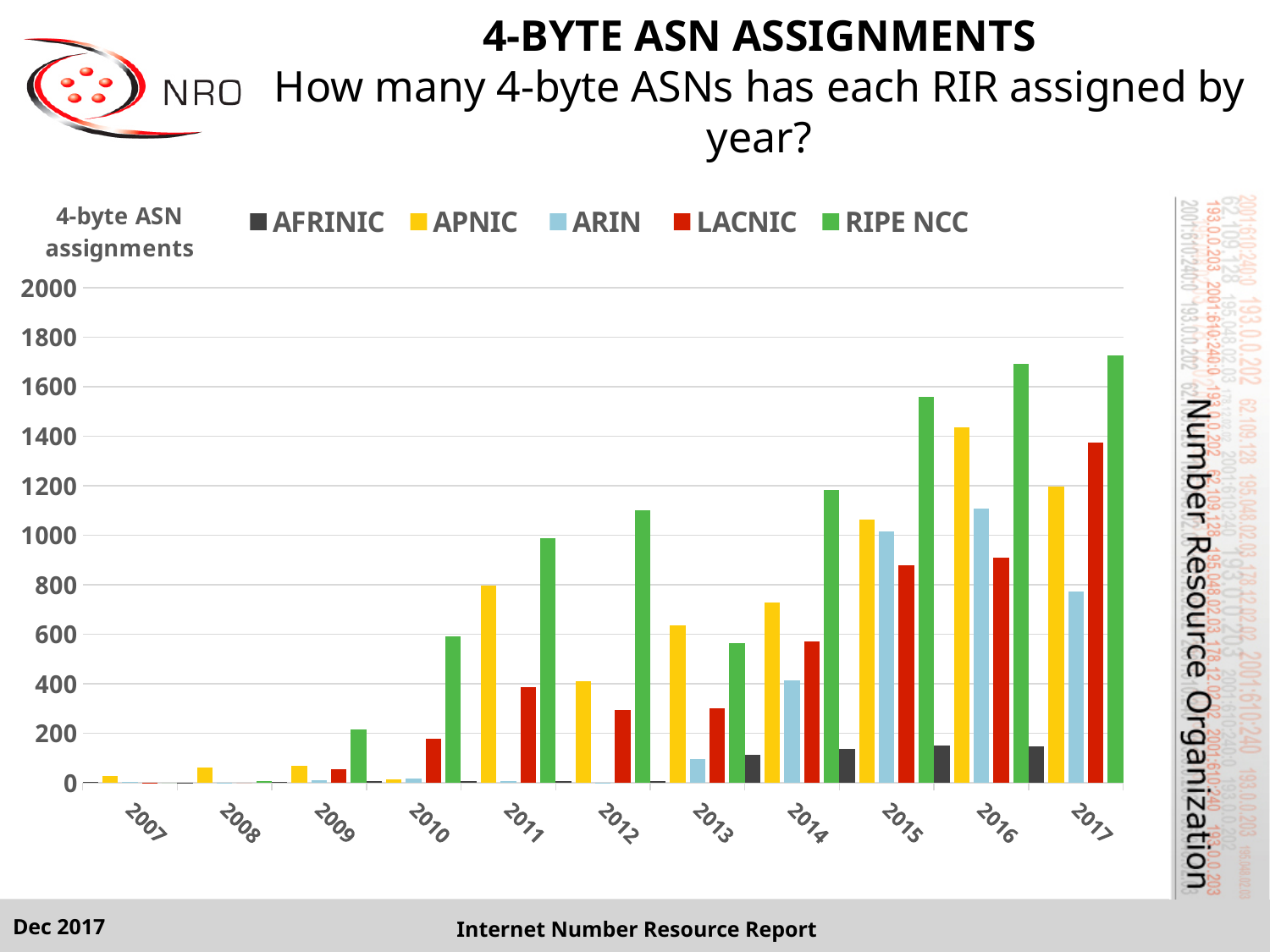
What colour represents RIPE NCC in the chart? green Which RIR has the lowest number of 4-byte ASN assignments in 2015? AFRINIC Is the value for RIPE NCC in 2015 greater or less than 1400? greater Is the value for ARIN in 2014 greater or less than 600? less Is the value for APNIC in 2016 greater or less than 1200? greater Which RIR has the highest number of 4-byte ASN assignments in 2017? RIPE NCC How many series does the legend list? 5 How many years are shown along the x axis? 11 In 2016, which is larger: the value for ARIN or the value for LACNIC? ARIN What kind of chart is shown on the slide? bar chart Do the RIPE NCC values rise or fall from 2014 to 2017? rise